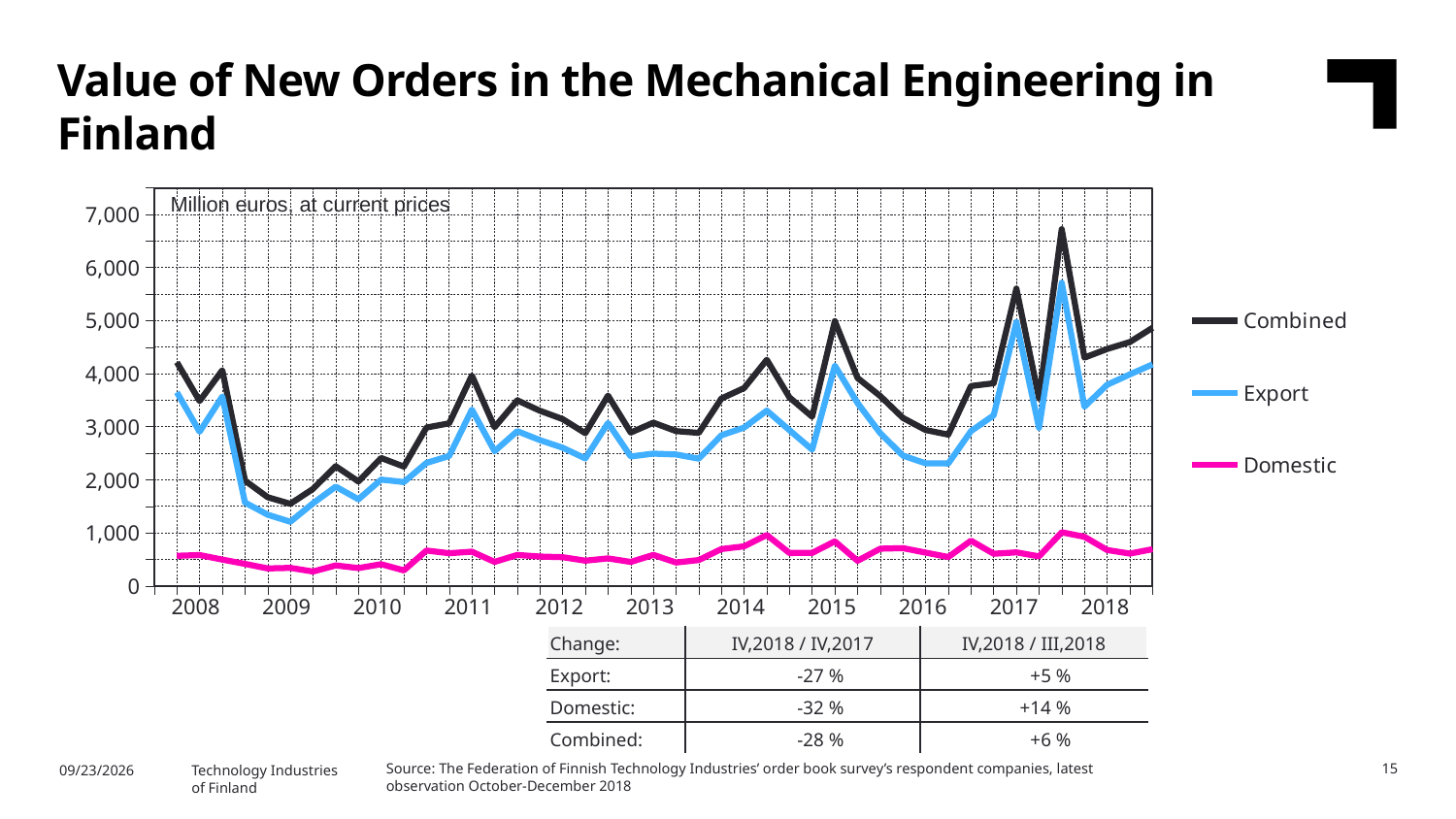
What kind of chart is shown on the slide? line chart How many series does the legend list? 3 Is the peak value of the Combined series in 2017 greater or less than 6,000? greater Which series has the highest values throughout the chart? Combined What unit is stated at the top of the chart's plot area? Million euros, at current prices What is the title of the chart on the slide? Value of New Orders in the Mechanical Engineering in Finland Is the lowest value of the Export series in 2009 greater or less than 2,000? less Which series has the lowest values throughout the chart? Domestic Does the Combined series rise or fall from the start of 2008 to 2009? fall In the change table below the chart, what is the Export change for IV,2018 / IV,2017? -27 % Is the peak value of the Export series in 2017 greater or less than 5,000? greater